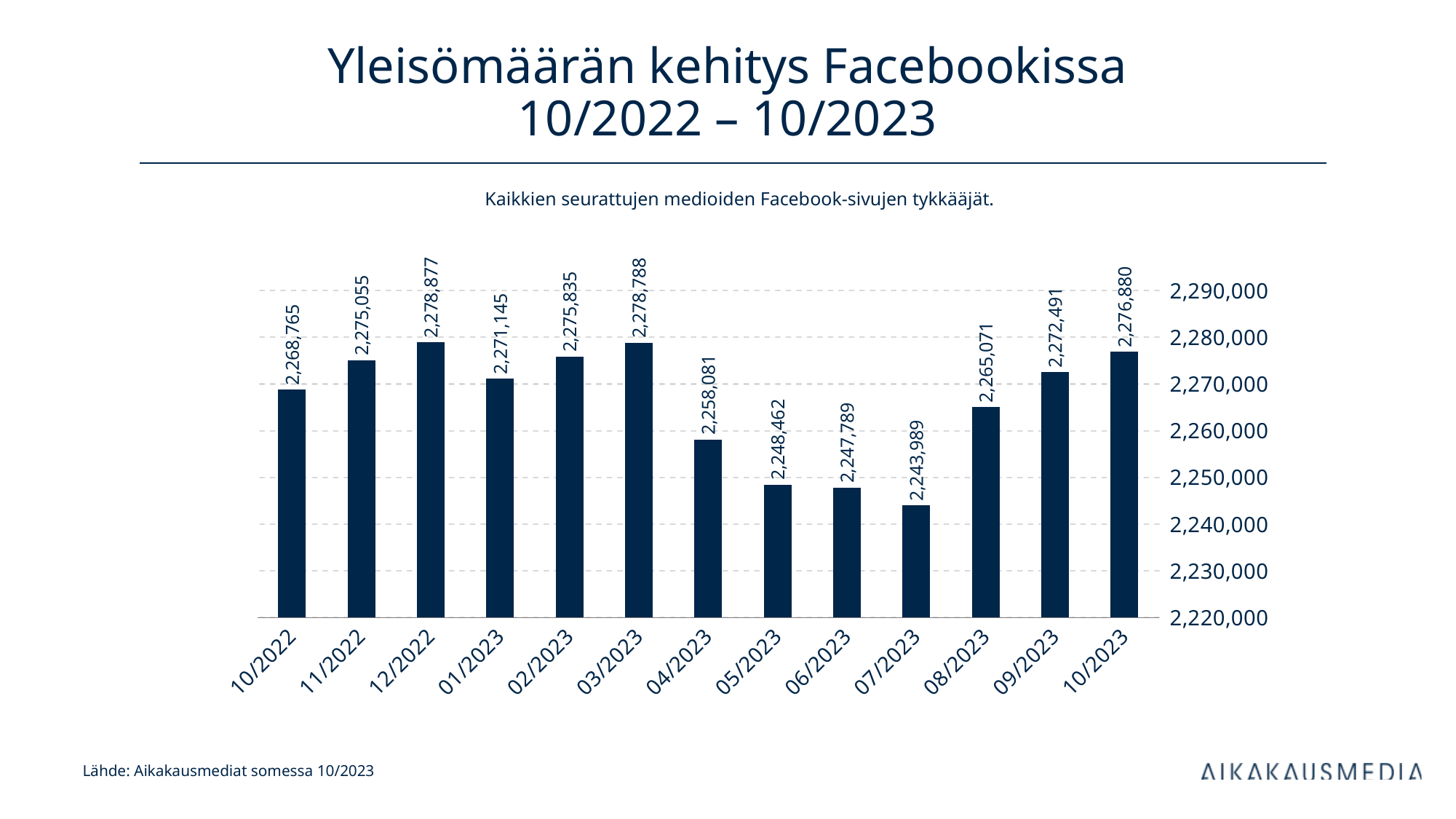
What is the value for 07/2023? 2,243,989 What is the value for 04/2023? 2,258,081 Do the values rise or fall from 03/2023 to 07/2023? fall What is the difference between the values for 12/2022 and 07/2023? 34,888 Which month has the lowest value? 07/2023 What is the value for 10/2023? 2,276,880 What is the difference between the values for 10/2023 and 10/2022? 8,115 What kind of chart is shown on the slide? bar chart Which is larger, the value for 05/2023 or the value for 08/2023? 08/2023 What is the value for 10/2022? 2,268,765 How many months are plotted on the chart? 13 Which month has the highest value? 12/2022